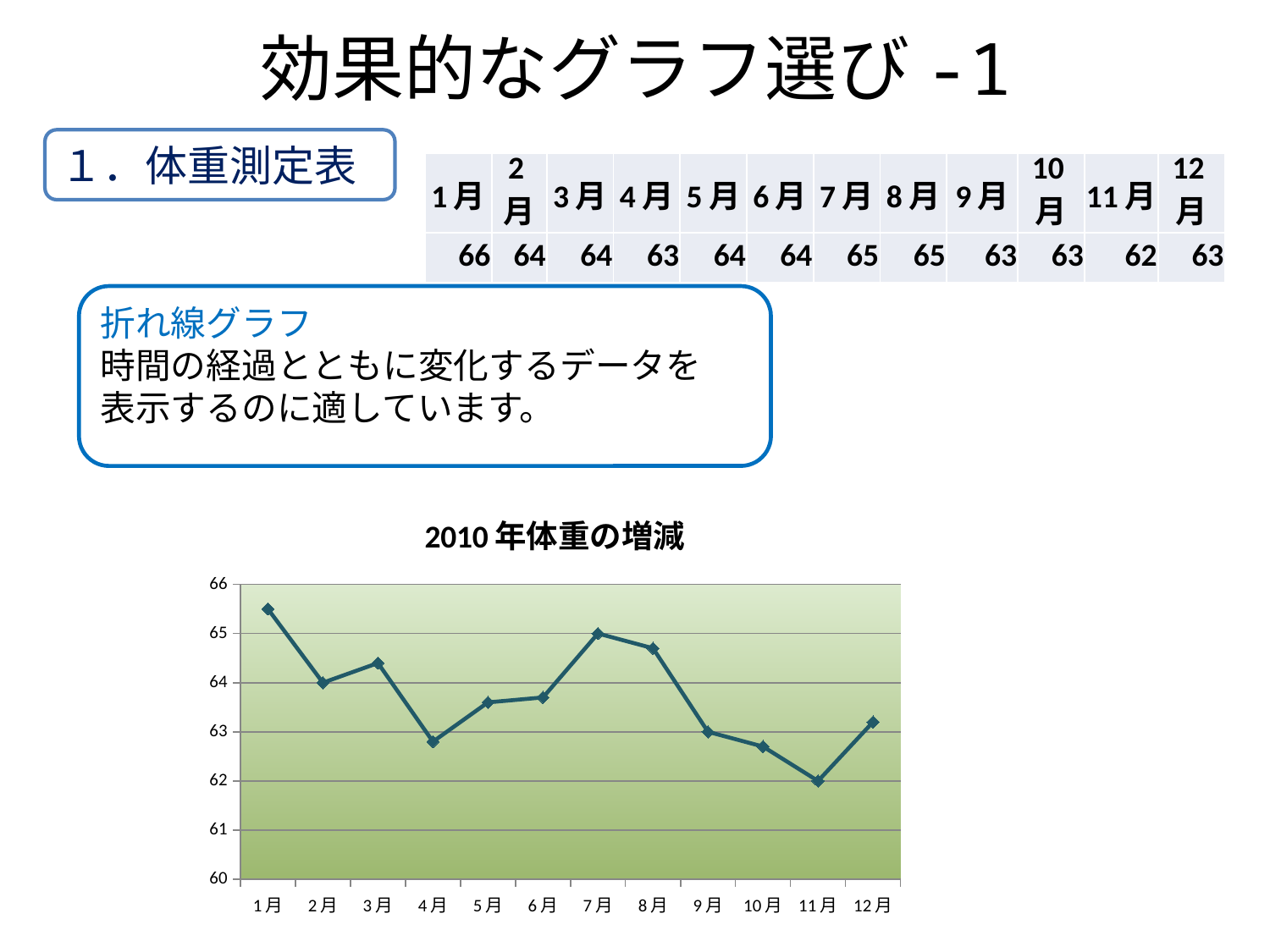
What is the value for 11月 on the chart? 62 What kind of chart is shown on the slide? line chart Is the value for 4月 greater or less than 64? less What is the value for 2月 on the chart? 64 Which month has the lowest value on the chart? 11月 Which is larger, the value for 3月 or the value for 5月? 3月 Which month has the highest value on the chart? 1月 What is the difference between the values for 7月 and 11月? 3 How many months (data points) are plotted on the chart? 12 What is the title of the chart? 2010年体重の増減 Is the value for 1月 greater or less than 65? greater What is the value for 7月 on the chart? 65